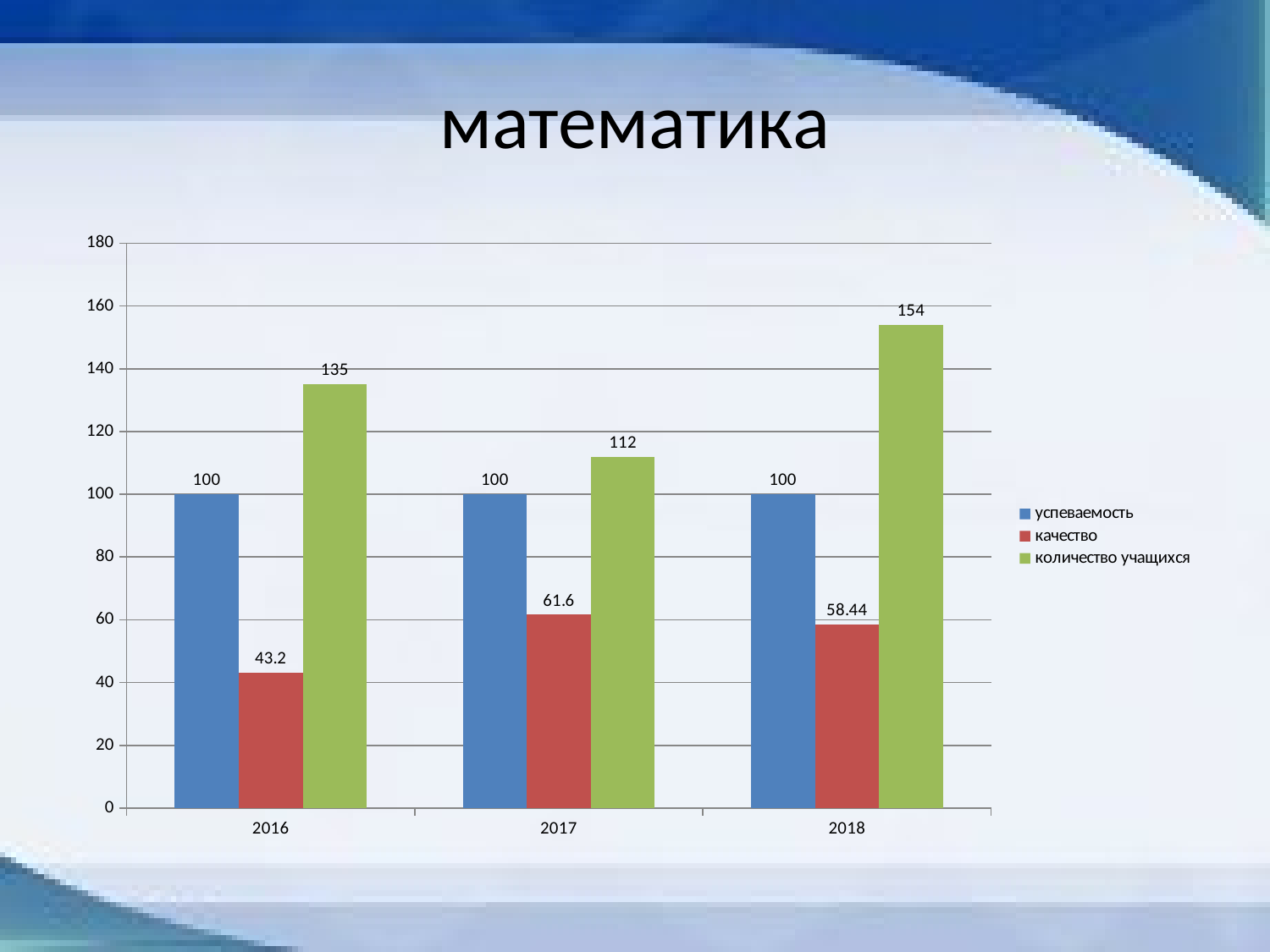
How many series does the legend list? 3 What is the title of the slide? математика What is the value of количество учащихся for 2018? 154 What is the difference between количество учащихся in 2018 and in 2016? 19 In which year is количество учащихся the highest? 2018 In which year is качество the lowest? 2016 Is the value of количество учащихся for 2017 greater or less than 100? greater How many years are shown on the x axis? 3 What is the value of качество for 2017? 61.6 Which is larger: качество in 2017 or качество in 2018? качество in 2017 What kind of chart is shown on the slide? bar chart What is the value of успеваемость for 2016? 100